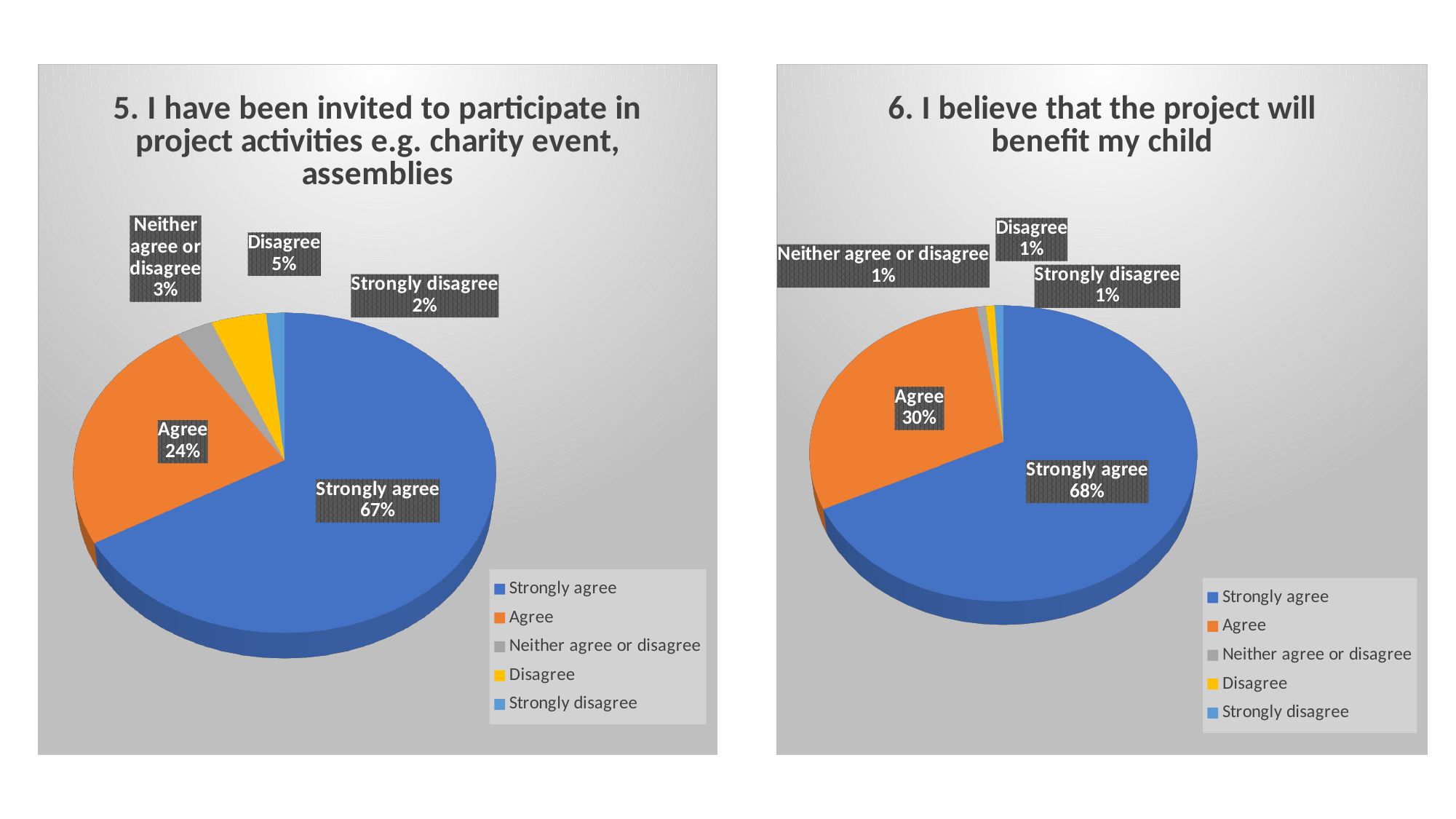
What type of chart is used on the left side of the slide (question 5)? Pie chart How many categories does the legend of the right chart (question 6) list? 5 In the left chart (question 5), which response has the smallest share? Strongly disagree In the right chart (question 6), what percentage of respondents chose Strongly agree? 68% In the left chart (question 5), what is the difference between the Strongly agree and Agree shares? 43% In the right chart (question 6), which is larger, the Agree share or the Neither agree or disagree share? Agree In the left chart (question 5), which response has the largest share? Strongly agree In the left chart (question 5), what percentage chose Disagree? 5% In the right chart (question 6), what percentage of respondents chose Agree? 30% In the right chart (question 6), which response has the largest share? Strongly agree In the left chart (question 5), what percentage of respondents chose Agree? 24% In the left chart (question 5), what percentage of respondents chose Strongly agree? 67%